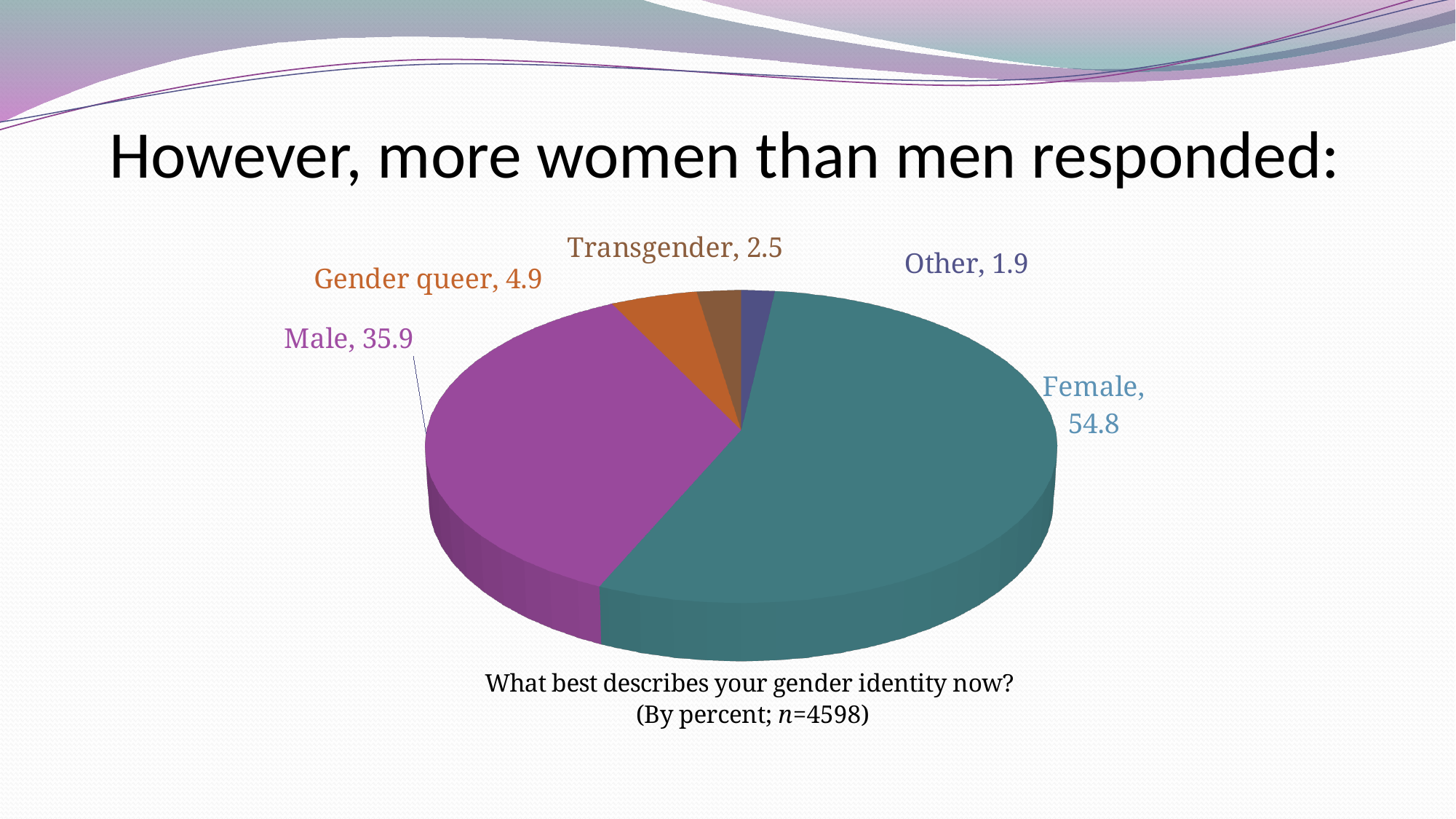
What kind of chart is shown on the slide? pie chart What is the value for Gender queer? 4.9 What is the value for Female? 54.8 How many categories does the pie chart show? 5 What is the value for Other? 1.9 Which is larger, Gender queer or Transgender? Gender queer Which category has the smallest slice? Other Which category has the largest slice? Female What is the value for Male? 35.9 What is the difference between the Female and Male values? 18.9 What is the value for Transgender? 2.5 What is the sample size (n) given in the chart caption? 4598